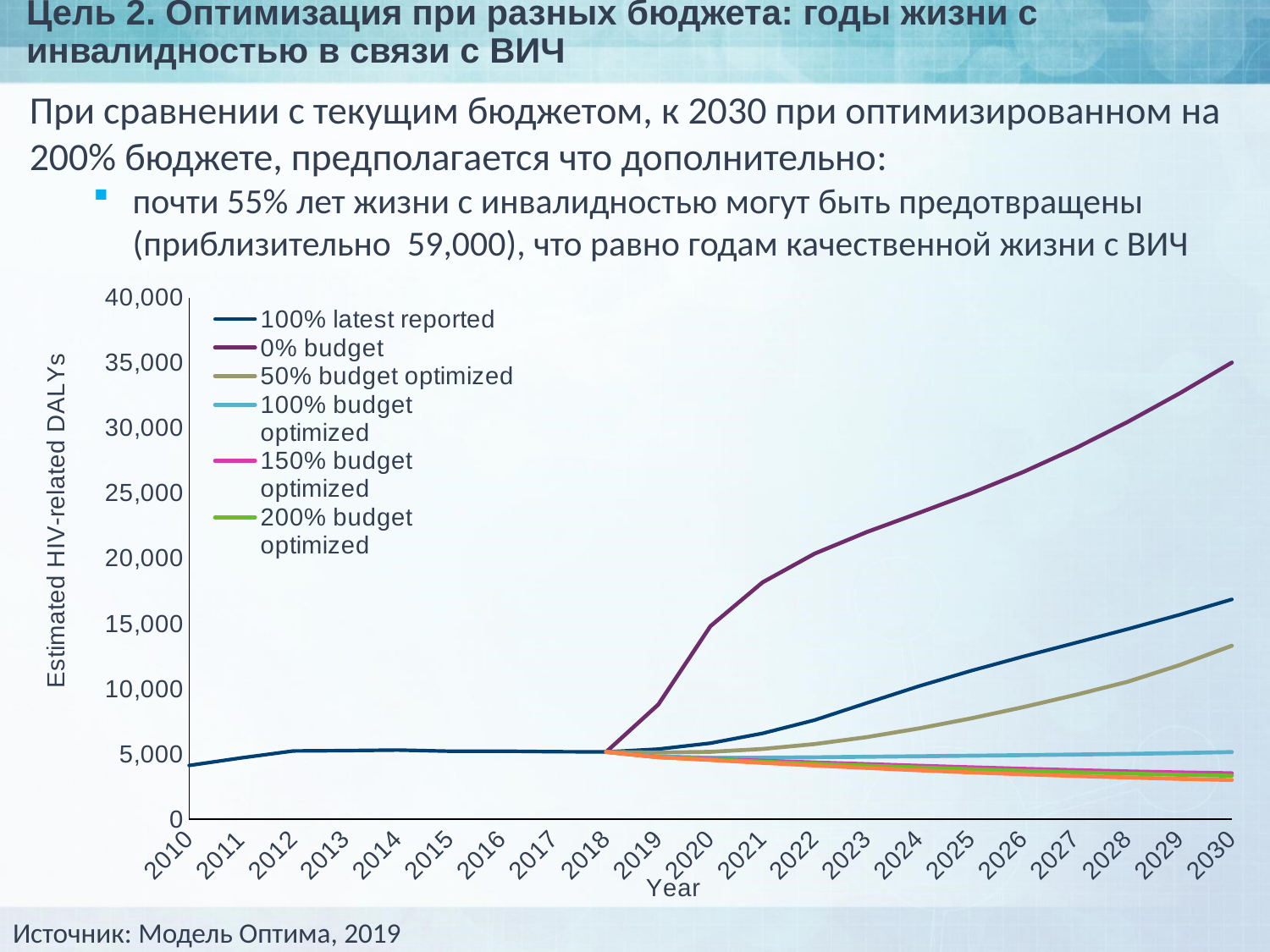
How many series does the chart legend list? 6 What kind of chart is shown on the slide? line chart How many years are labelled on the x axis of the chart? 21 What is the label of the y axis of the chart? Estimated HIV-related DALYs Does the 200% budget optimized series rise or fall between 2018 and 2030? fall Which series has the highest value in 2030? 0% budget Is the value of the 0% budget series in 2021 greater or less than 15,000? greater Does the 0% budget series rise or fall between 2018 and 2030? rise Is the value of the 50% budget optimized series in 2030 greater or less than 15,000? less In 2030, which is larger: the 100% latest reported series or the 50% budget optimized series? 100% latest reported Is the value of the 100% latest reported series in 2030 greater or less than 15,000? greater